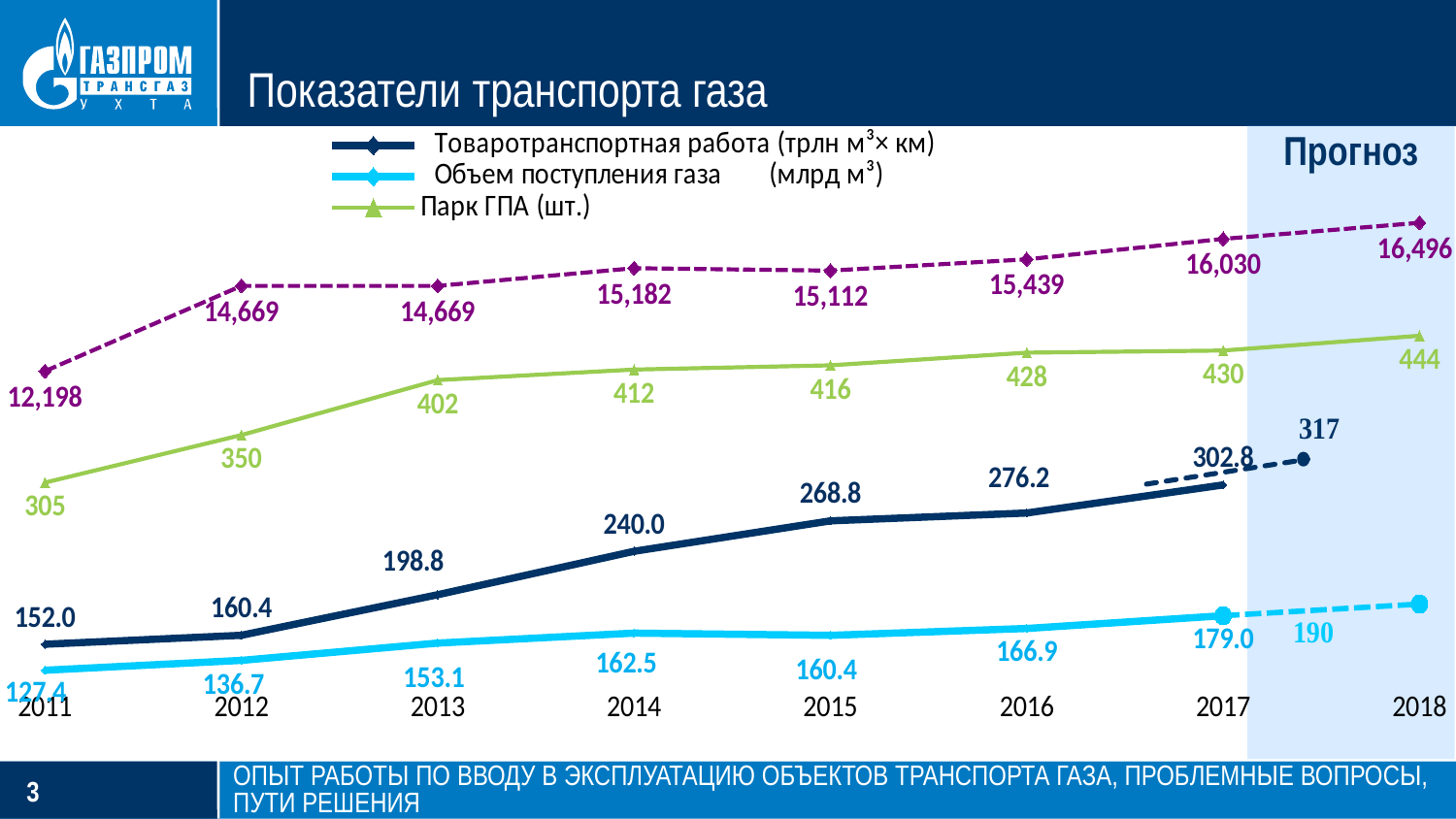
In which year is Объем поступления газа lowest? 2011 What type of chart is shown on the slide? line chart What is the value of Объем поступления газа in 2017? 179.0 What is the value of Товаротранспортная работа in 2014? 240.0 Does Парк ГПА rise or fall from 2011 to 2018? rise What is the difference between Товаротранспортная работа in 2017 and in 2011? 150.8 Which is larger: Объем поступления газа in 2014 or in 2015? 2014 How many years are shown on the x axis? 8 How many series does the legend list? 3 What is the value of Парк ГПА in 2013? 402 In which year is Товаротранспортная работа highest? 2018 What is the forecast value of Парк ГПА for 2018? 444